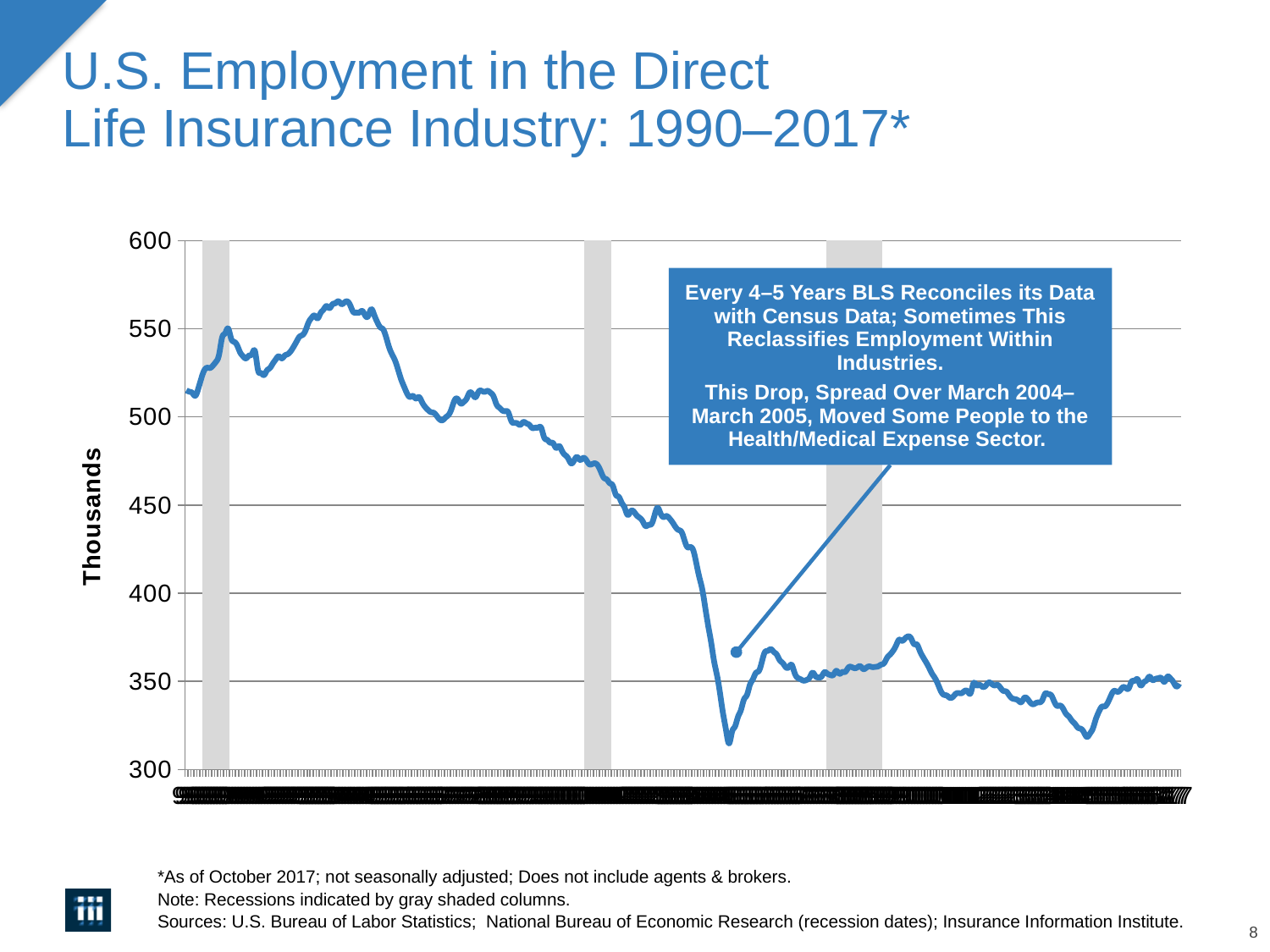
Overall, do the values rise or fall from the left of the chart to the right? Fall Is the highest point on the line greater or less than 550? greater What is the label on the vertical axis? Thousands What kind of chart is shown on the slide? Line chart Is the lowest point on the line greater or less than 350? less Is the value at the left-hand start of the line greater or less than 500? greater What do the gray shaded columns on the chart indicate? Recessions